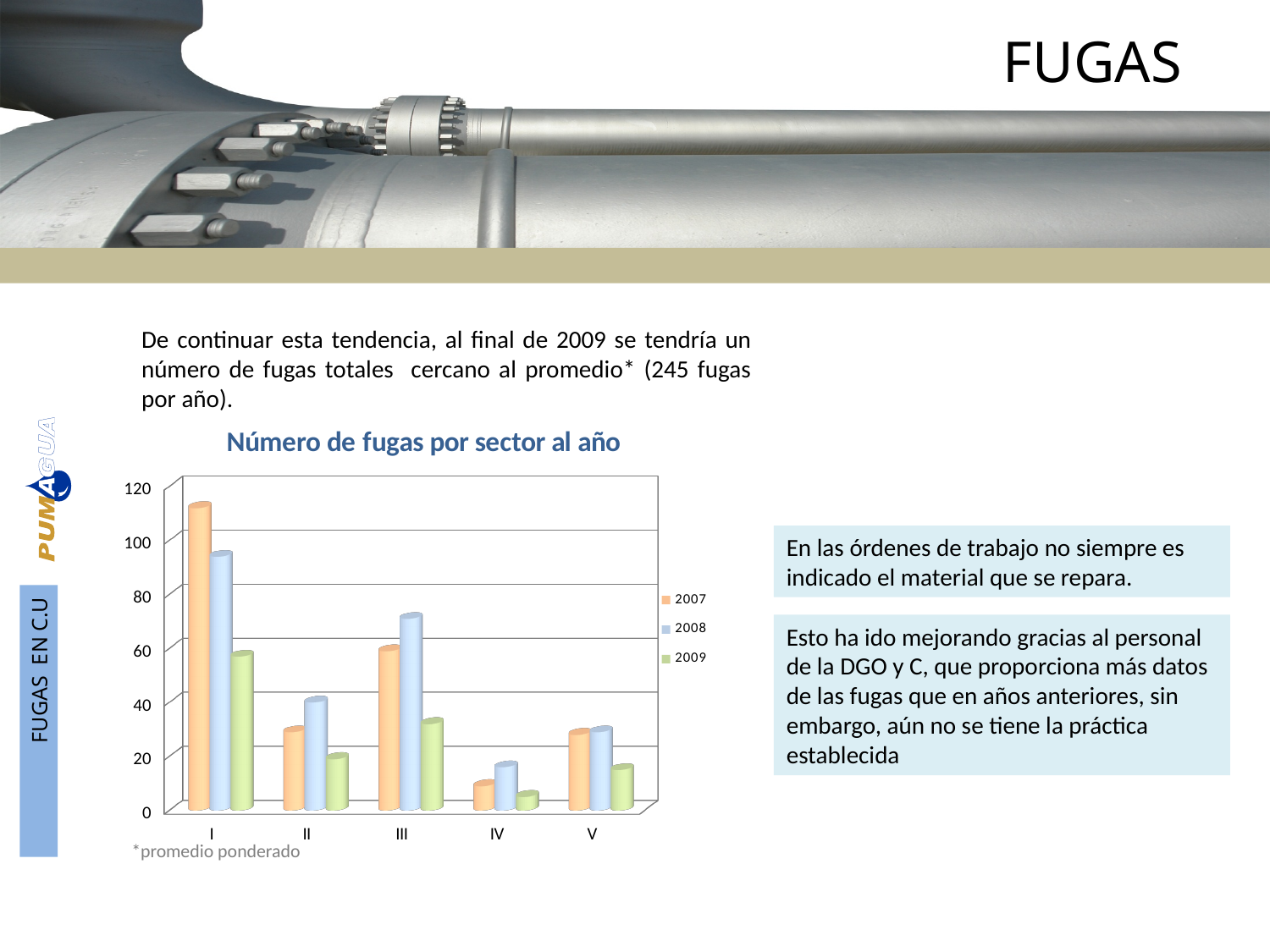
Which sector has the highest value for 2007? I Is the value for 2007 in sector I greater or less than 100? greater Is the value for 2009 in sector IV greater or less than 20? less In sector II, which is larger: the value for 2007 or the value for 2008? 2008 Which sector has the highest value for 2008? I Which sector has the lowest value for 2009? IV Is the value for 2008 in sector III greater or less than 60? greater How many sectors (categories) are shown on the x axis of the chart? 5 Which years are listed in the chart legend? 2007, 2008, 2009 What kind of chart is shown on the slide? bar chart How many series does the chart legend list? 3 What is the title of the chart? Número de fugas por sector al año